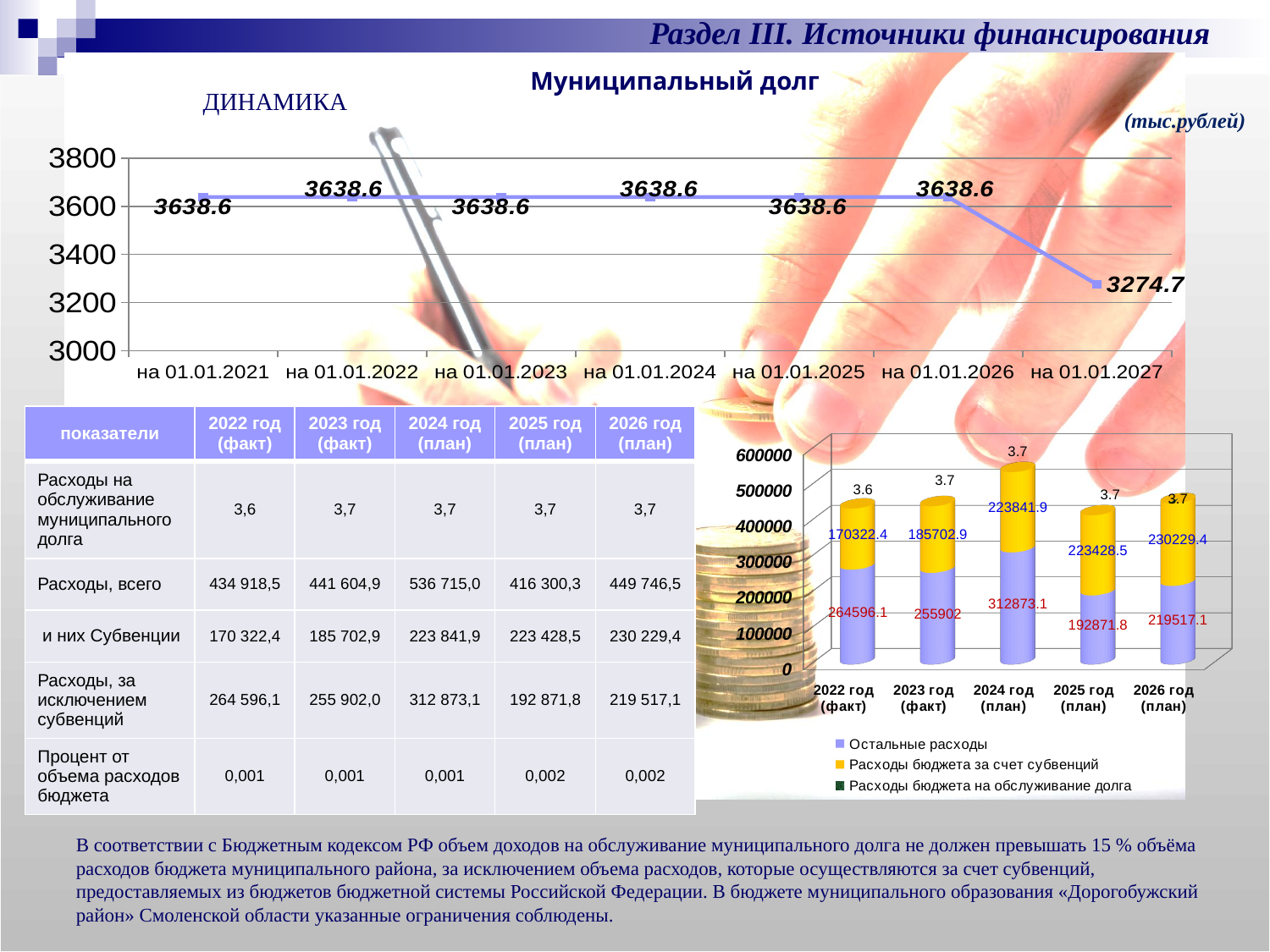
In the bottom-right bar chart, what is the value of 'Остальные расходы' for 2024 год (план)? 312873.1 How many series does the legend of the bottom-right bar chart list? 3 In the bottom-right bar chart, what is the difference between 'Остальные расходы' for 2024 год (план) and 2025 год (план)? 120001.3 In the 'Муниципальный долг' line chart, what is the value for на 01.01.2021? 3638.6 What kind of chart is the 'Муниципальный долг' chart at the top of the slide? line chart How many data points are plotted in the 'Муниципальный долг' line chart? 7 In the 'Муниципальный долг' line chart, which date has the lowest value? на 01.01.2027 What kind of chart is the chart at the bottom right of the slide? bar chart In the bottom-right bar chart, which year has the highest value for 'Остальные расходы'? 2024 год (план) In the 'Муниципальный долг' line chart, what is the difference between the values for на 01.01.2026 and на 01.01.2027? 363.9 In the bottom-right bar chart, what is the value of 'Расходы бюджета за счет субвенций' for 2026 год (план)? 230229.4 In the 'Муниципальный долг' line chart, what is the value for на 01.01.2027? 3274.7